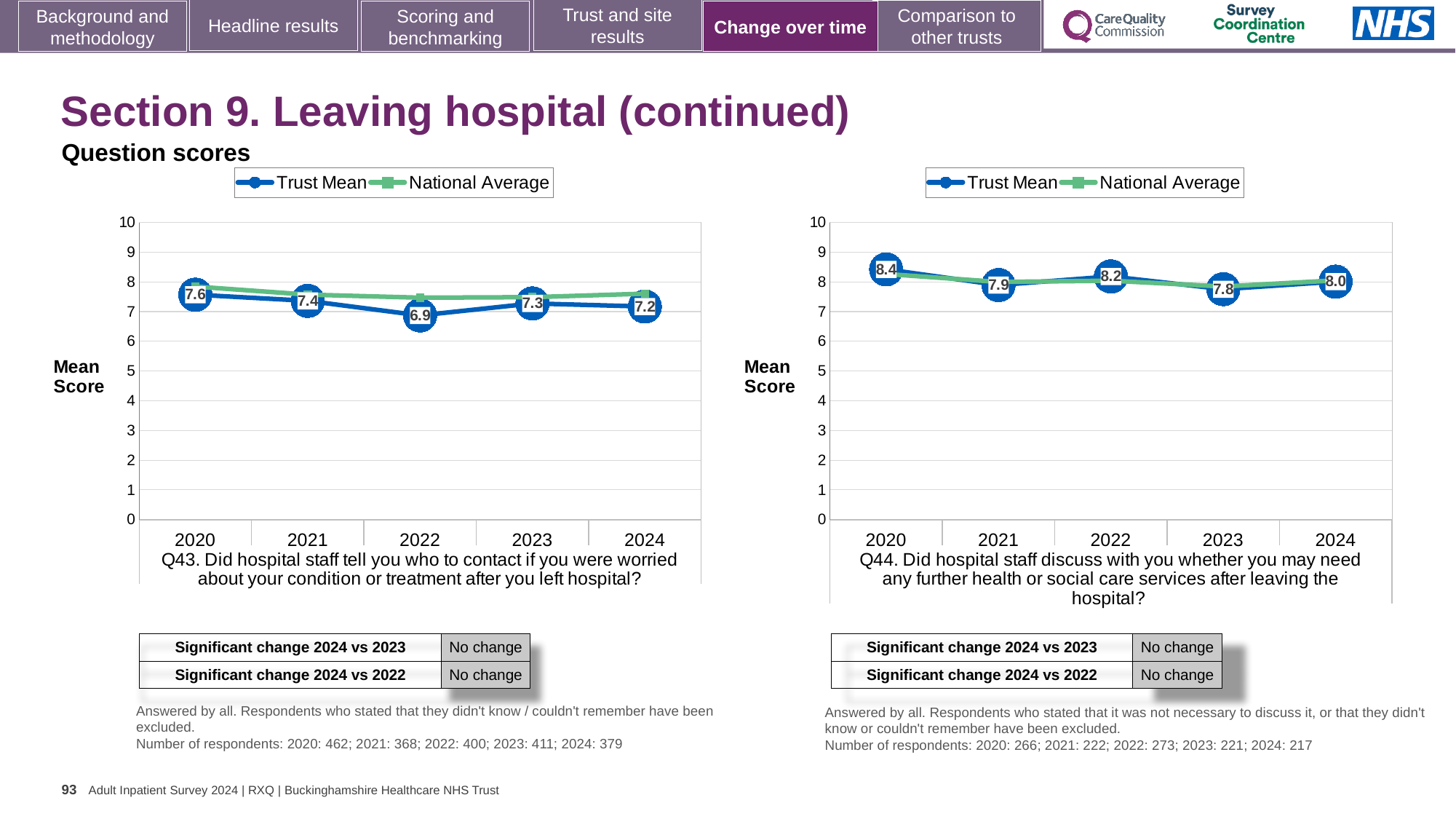
In the Q44 chart (right), what is the difference between the Trust Mean scores for 2020 and 2023? 0.6 In the Q43 chart (left), which year has the lowest Trust Mean score? 2022 How many series does the legend of the Q43 chart (left) list? 2 In the Q43 chart (left), does the Trust Mean score rise or fall from 2020 to 2022? Fall What does the y axis of the Q43 chart (left) represent? Mean Score In the Q43 chart (left), is the National Average value for 2022 greater or less than 7? greater In the Q44 chart (right), which year has the highest Trust Mean score? 2020 In the Q43 chart (left), what is the Trust Mean score for 2022? 6.9 What type of chart is used for Q44 (right)? Line chart In the Q44 chart (right), what is the Trust Mean score for 2020? 8.4 How many years are plotted on the x axis of the Q44 chart (right)? 5 In the Q43 chart (left), is the Trust Mean score higher in 2020 or in 2024? 2020